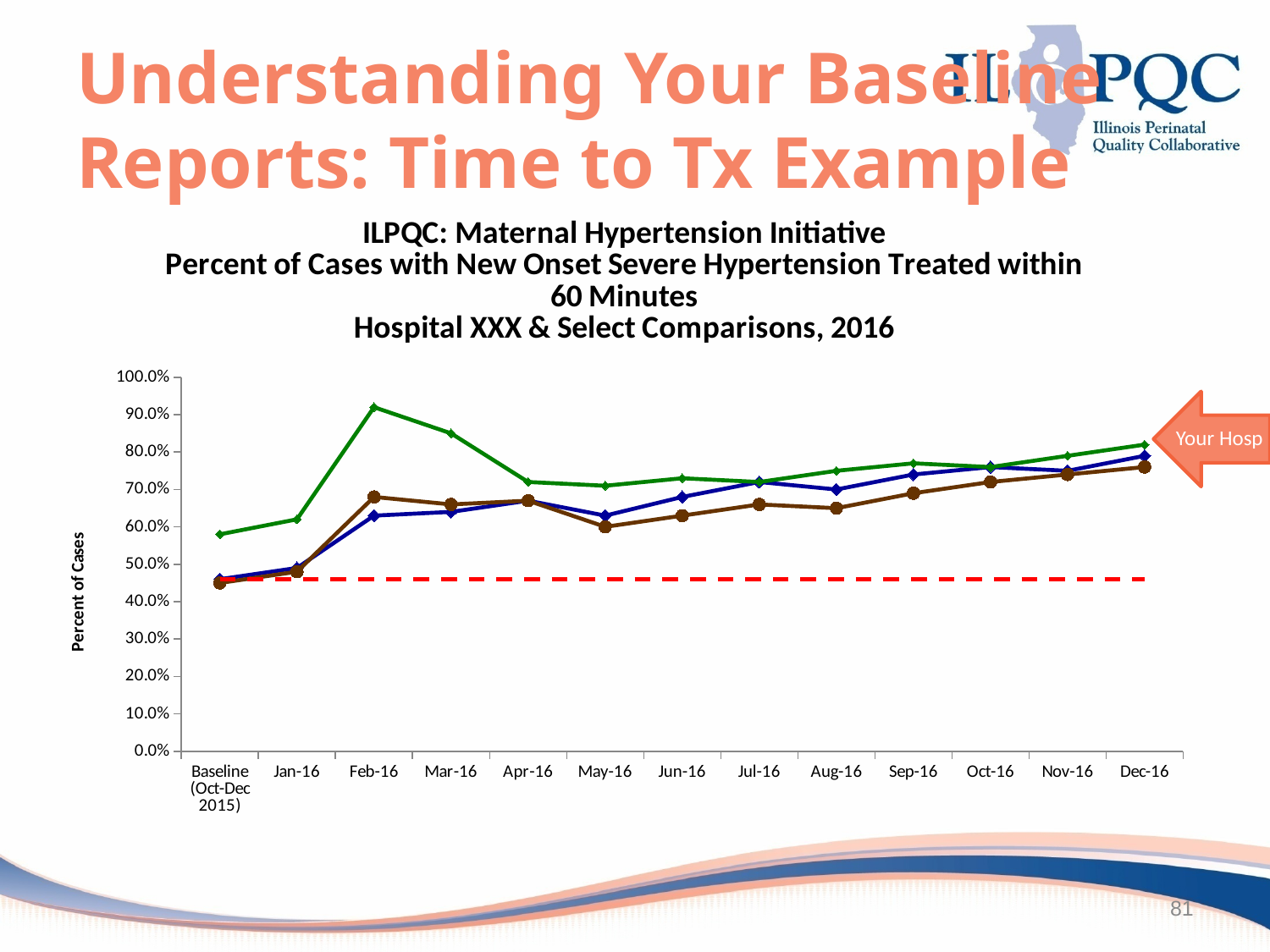
What kind of chart is shown on the slide? line chart Is the value of the green line at the Baseline (Oct-Dec 2015) point greater or less than 50.0%? greater Is the value of the green line at Feb-16 greater or less than 90.0%? greater Is the value of the red dashed line greater or less than 50.0%? less Does the green line rise or fall between Feb-16 and Apr-16? fall At Feb-16, which line has the higher value, the green line or the blue line? green line What is the first line of the chart's title? ILPQC: Maternal Hypertension Initiative At which time point does the green line reach its highest value? Feb-16 How many time points are shown along the x axis of the chart? 13 What is the label of the y axis of the chart? Percent of Cases At which time point is the green line at its lowest value? Baseline (Oct-Dec 2015)